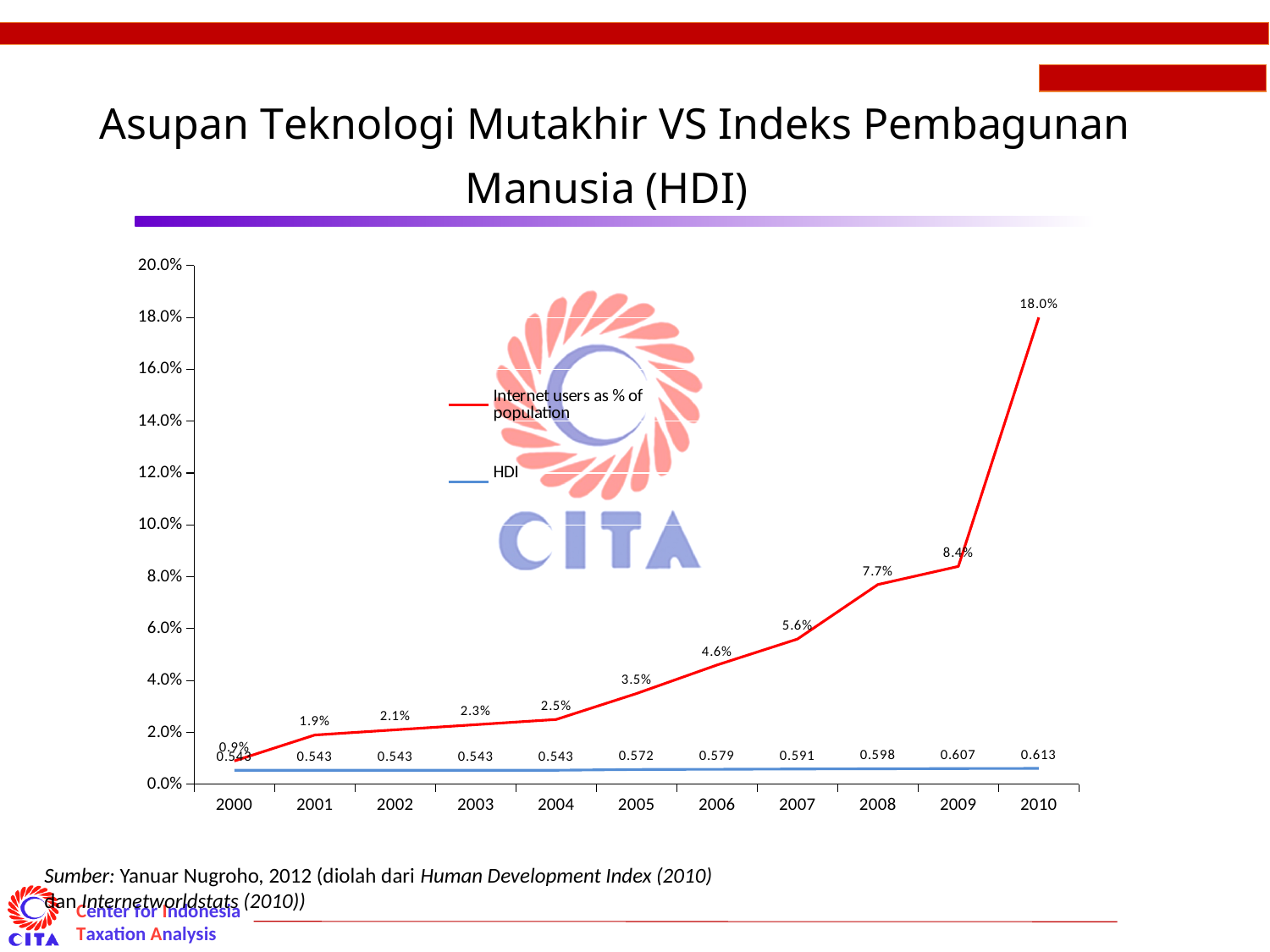
What is the difference in Internet users as % of population between 2010 and 2009? 9.6% In which year is Internet users as % of population lowest? 2000 What is the value of Internet users as % of population in 2007? 5.6% Does Internet users as % of population rise or fall from 2000 to 2010? Rise What is the HDI value for 2010? 0.613 What is the HDI value for 2005? 0.572 What is the value of Internet users as % of population in 2010? 18.0% How many years are shown on the x axis? 11 How many series does the legend list? 2 What kind of chart is shown on the slide? Line chart In which year is Internet users as % of population highest? 2010 Which year has a higher Internet users as % of population, 2006 or 2008? 2008